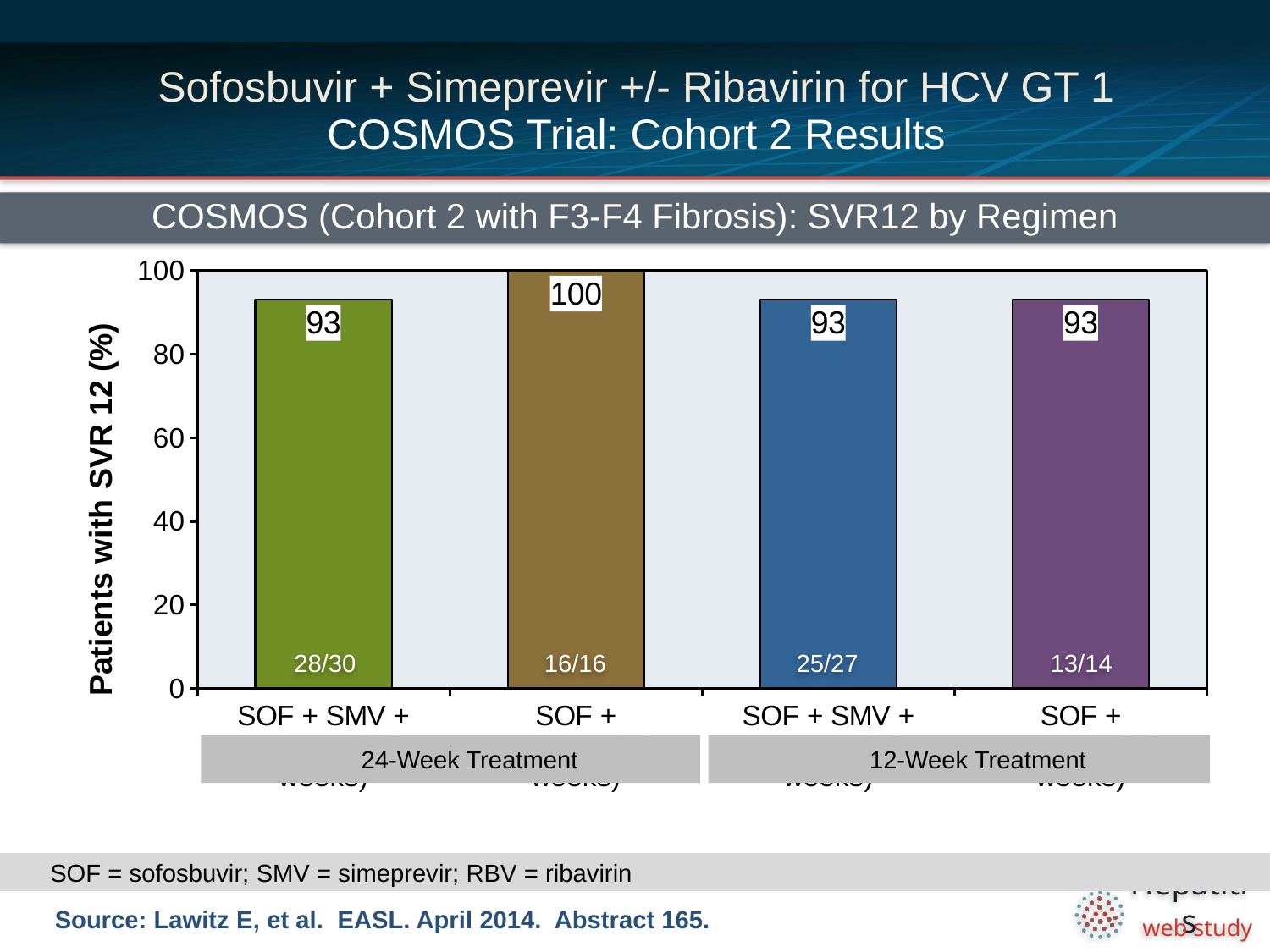
What is the SVR12 value for the first bar (SOF + SMV + ..., 24-Week Treatment)? 93 Is the SVR12 value for the third bar (12-Week Treatment, SOF + SMV + ...) greater or less than 80? greater What is the label of the y-axis? Patients with SVR 12 (%) How many bars are plotted in the chart? 4 What is the SVR12 value for the third bar (SOF + SMV + ..., 12-Week Treatment)? 93 What is the SVR12 value for the fourth bar (SOF + ..., 12-Week Treatment)? 93 What is the difference in SVR12 between the second bar (100) and the first bar (93)? 7 Which bar has the highest SVR12 value? SOF + ... (24-Week Treatment), the second bar What patient fraction is printed at the bottom of the fourth bar (12-Week Treatment, SOF + ...)? 13/14 What patient fraction is printed at the bottom of the first bar (24-Week Treatment, SOF + SMV + ...)? 28/30 What is the SVR12 value for the second bar (SOF + ..., 24-Week Treatment)? 100 What type of chart is shown on the slide? bar chart